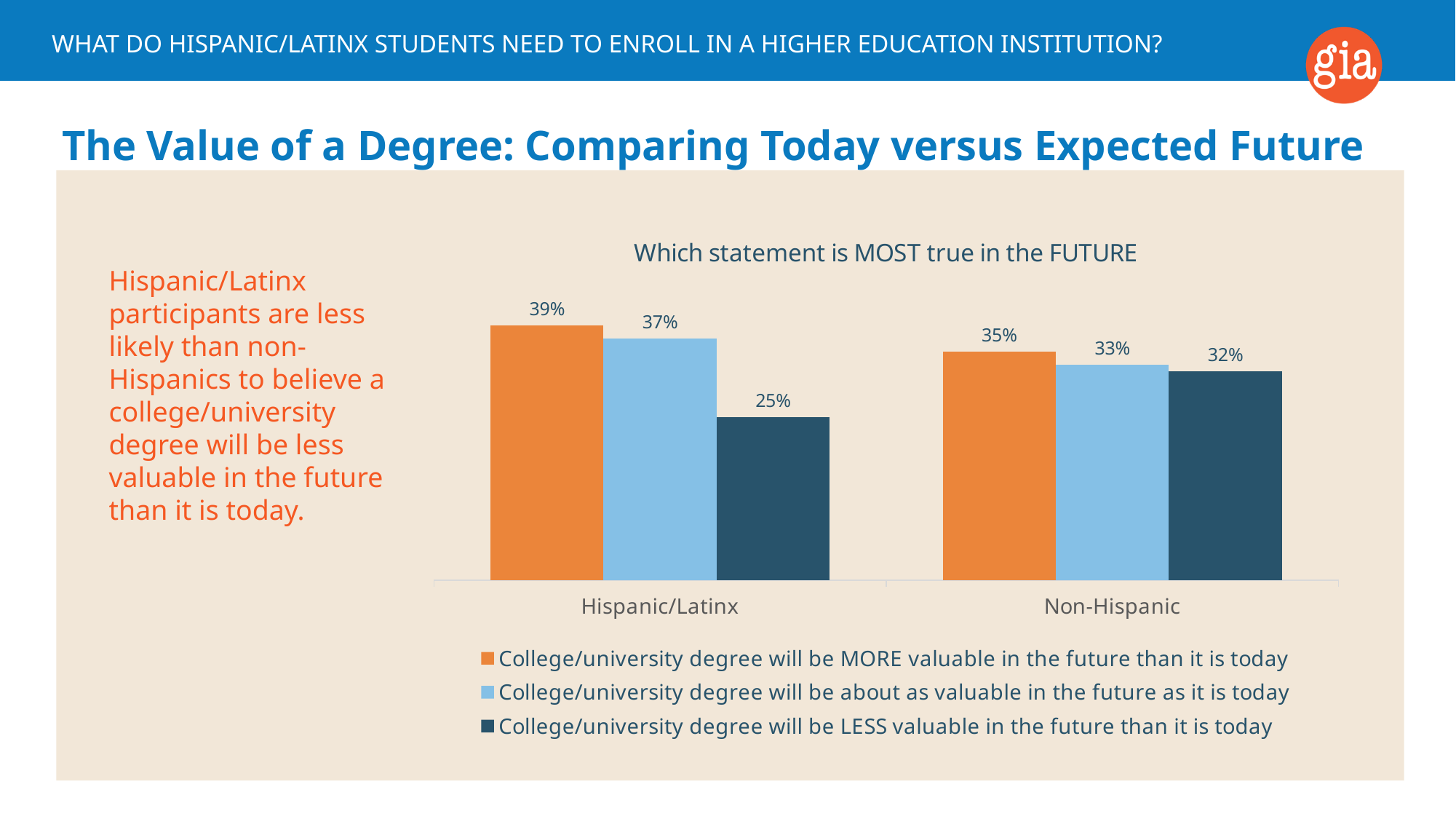
Which colour represents the statement that a college/university degree will be about as valuable in the future as it is today? Light blue Which statement has the highest value among Non-Hispanic participants? College/university degree will be MORE valuable in the future than it is today What is the difference between the Non-Hispanic and Hispanic/Latinx values for the statement that a degree will be LESS valuable in the future? 7% What percentage of Hispanic/Latinx participants said a college/university degree will be MORE valuable in the future than it is today? 39% What percentage of Non-Hispanic participants said a college/university degree will be LESS valuable in the future than it is today? 32% What is the title of the chart? Which statement is MOST true in the FUTURE What percentage of Hispanic/Latinx participants said a college/university degree will be about as valuable in the future as it is today? 37% Which group has a larger value for the statement that a degree will be MORE valuable in the future: Hispanic/Latinx or Non-Hispanic? Hispanic/Latinx Which statement has the lowest value among Hispanic/Latinx participants? College/university degree will be LESS valuable in the future than it is today What kind of chart is shown on the slide? Bar chart How many groups are shown on the x axis of the chart? 2 How many series does the legend list? 3